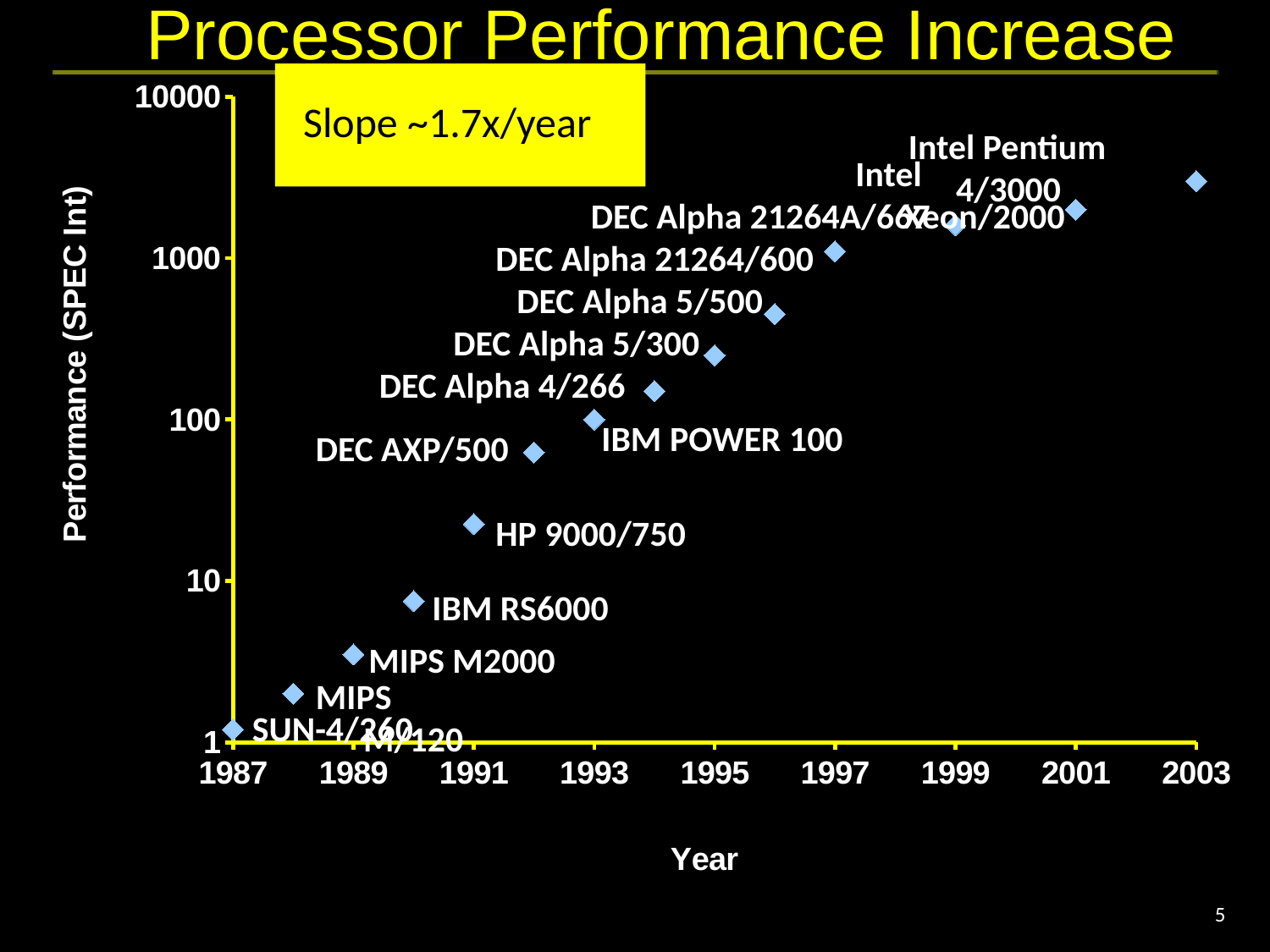
Which processor has the lowest performance on the chart? SUN-4/260 What is the label of the y axis? Performance (SPEC Int) In which year is the highest performance point plotted? 2003 What kind of chart is shown on the slide? scatter chart Which has the higher performance, IBM RS6000 or HP 9000/750? HP 9000/750 Is the performance value for Intel Pentium 4/3000 greater or less than 1000? greater What is the title of the chart? Processor Performance Increase Is the performance value for HP 9000/750 greater or less than 10? greater Is the performance value for DEC Alpha 5/500 greater or less than 1000? less Do the performance values rise or fall as the year increases? rise